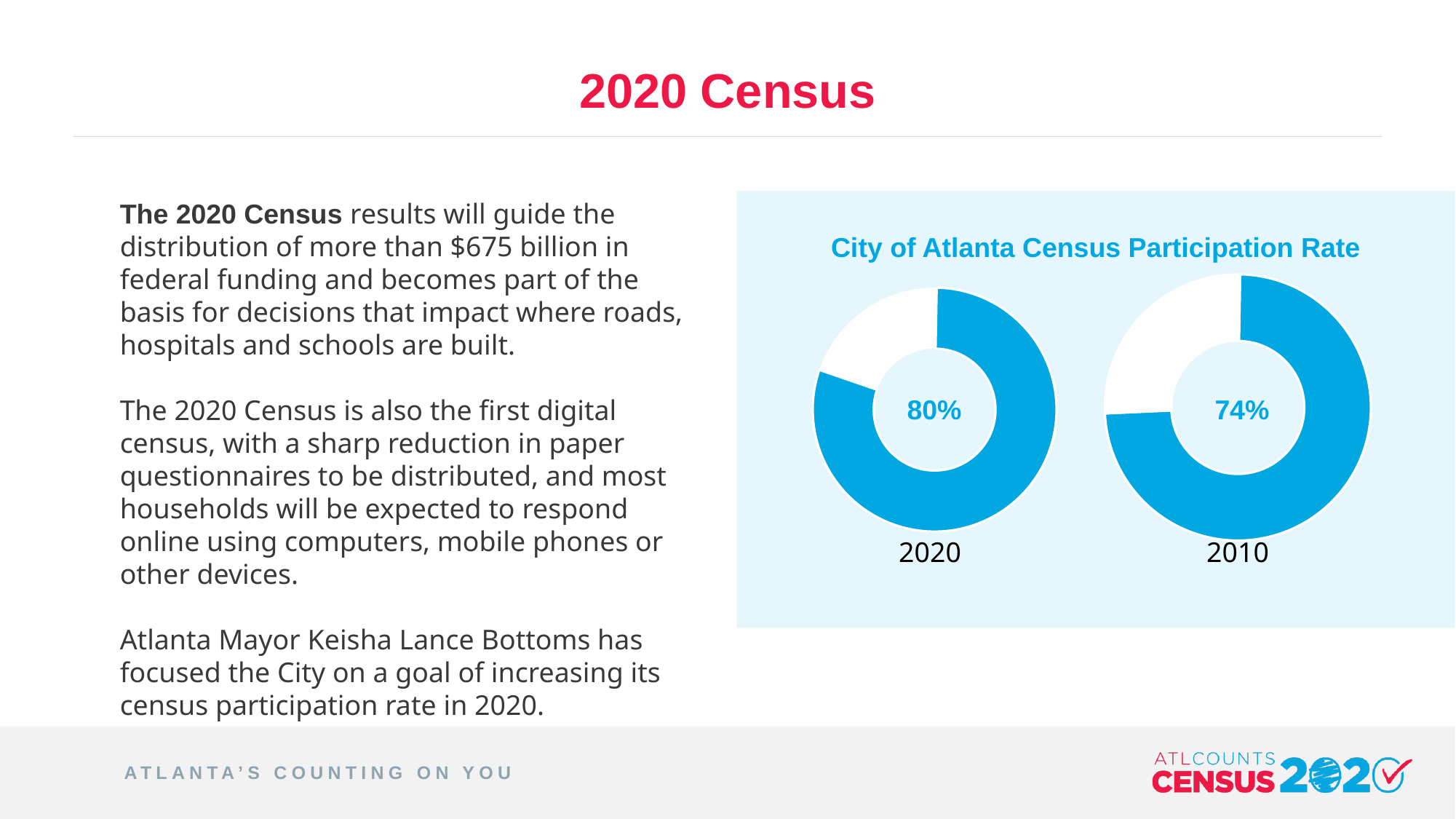
Is the 2010 participation rate greater or less than 75%? less What is the City of Atlanta census participation rate shown for 2020? 80% Which year has the higher census participation rate, 2020 or 2010? 2020 Which year shows the lowest census participation rate? 2010 How many donut charts are shown under the 'City of Atlanta Census Participation Rate' heading? 2 What colour is the filled portion of the donut charts? Blue What is the City of Atlanta census participation rate shown for 2010? 74% By how many percentage points does the 2020 participation rate exceed the 2010 rate? 6 percentage points What is the title of the chart area on the right side of the slide? City of Atlanta Census Participation Rate What kind of chart is used to show the census participation rates? Donut (pie) chart Which years are labelled beneath the two donut charts? 2020 and 2010